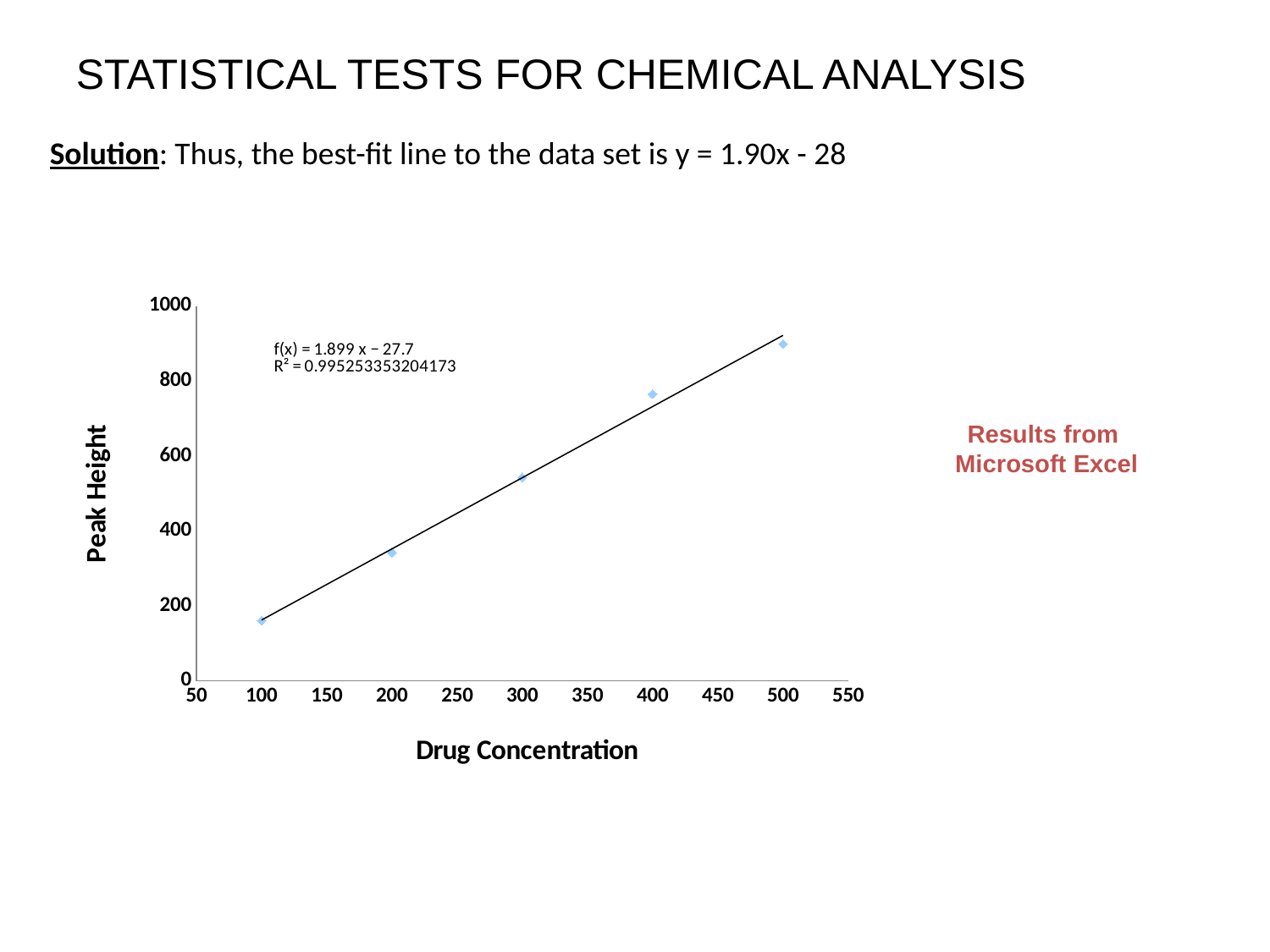
What is the label of the y axis? Peak Height Is the Peak Height at a Drug Concentration of 400 greater or less than 800? less What is the trendline equation displayed on the chart? f(x) = 1.899 x − 27.7 Which has the larger Peak Height: the point at Drug Concentration 200 or the point at Drug Concentration 400? 400 What kind of chart is shown on the slide? scatter plot At which Drug Concentration is the Peak Height highest? 500 At which Drug Concentration is the Peak Height lowest? 100 Is the Peak Height at a Drug Concentration of 300 greater or less than 400? greater How many data points are plotted on the chart? 5 Is the Peak Height at a Drug Concentration of 500 greater or less than 800? greater Do the Peak Height values rise or fall as Drug Concentration increases? rise